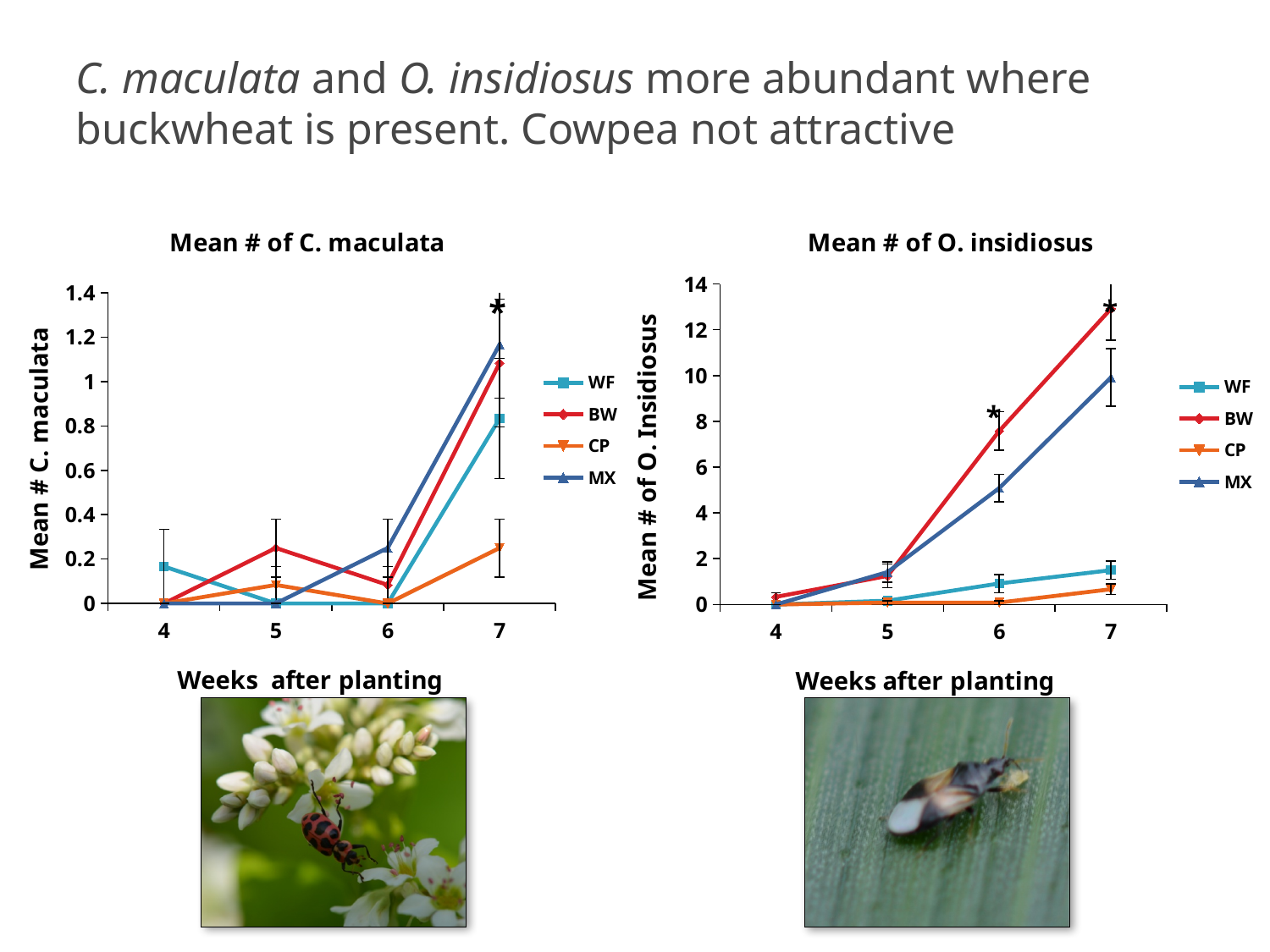
What kind of chart is the "Mean # of C. maculata" chart? line chart In the "Mean # of C. maculata" chart, is the value for WF at week 7 greater or less than 0.6? greater What is the x-axis label of the "Mean # of O. insidiosus" chart? Weeks after planting How many weeks after planting are plotted on the x axis of the "Mean # of C. maculata" chart? 4 How many series does the legend of the "Mean # of O. insidiosus" chart list? 4 In the "Mean # of C. maculata" chart, which series has the lowest value at week 7? CP In the "Mean # of C. maculata" chart, is the value for CP at week 7 greater or less than 0.4? less In the "Mean # of O. insidiosus" chart, which is larger at week 7, the value for MX or the value for WF? MX In the "Mean # of O. insidiosus" chart, does the BW series rise or fall from week 5 to week 7? rise In the "Mean # of O. insidiosus" chart, which series has the highest value at week 7? BW In the "Mean # of O. insidiosus" chart, is the value for BW at week 6 greater or less than 6? greater